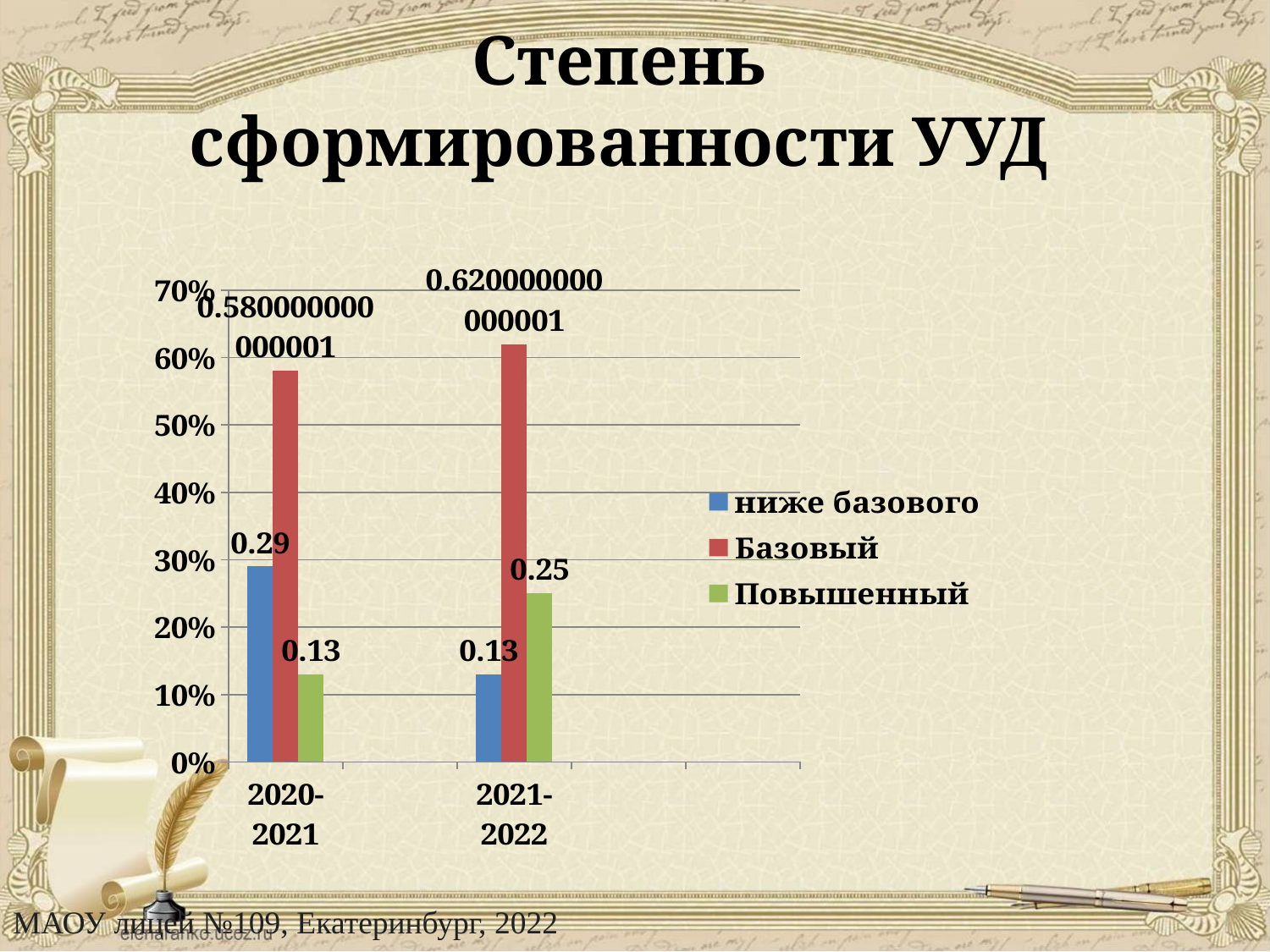
How many categories are shown on the x axis? 2 How many series does the legend list? 3 Is the value for Базовый in 2020-2021 greater or less than 50%? greater Which is larger: Повышенный in 2020-2021 or Повышенный in 2021-2022? Повышенный in 2021-2022 What is the value for ниже базового in 2021-2022? 0.13 What is the difference between ниже базового and Повышенный in 2020-2021? 0.16 What is the value for Повышенный in 2021-2022? 0.25 What is the value for ниже базового in 2020-2021? 0.29 What kind of chart is shown on the slide? bar chart Which series has the highest value in 2020-2021? Базовый Which series has the lowest value in 2021-2022? ниже базового What is the data label shown for Базовый in 2021-2022? 0.620000000000001